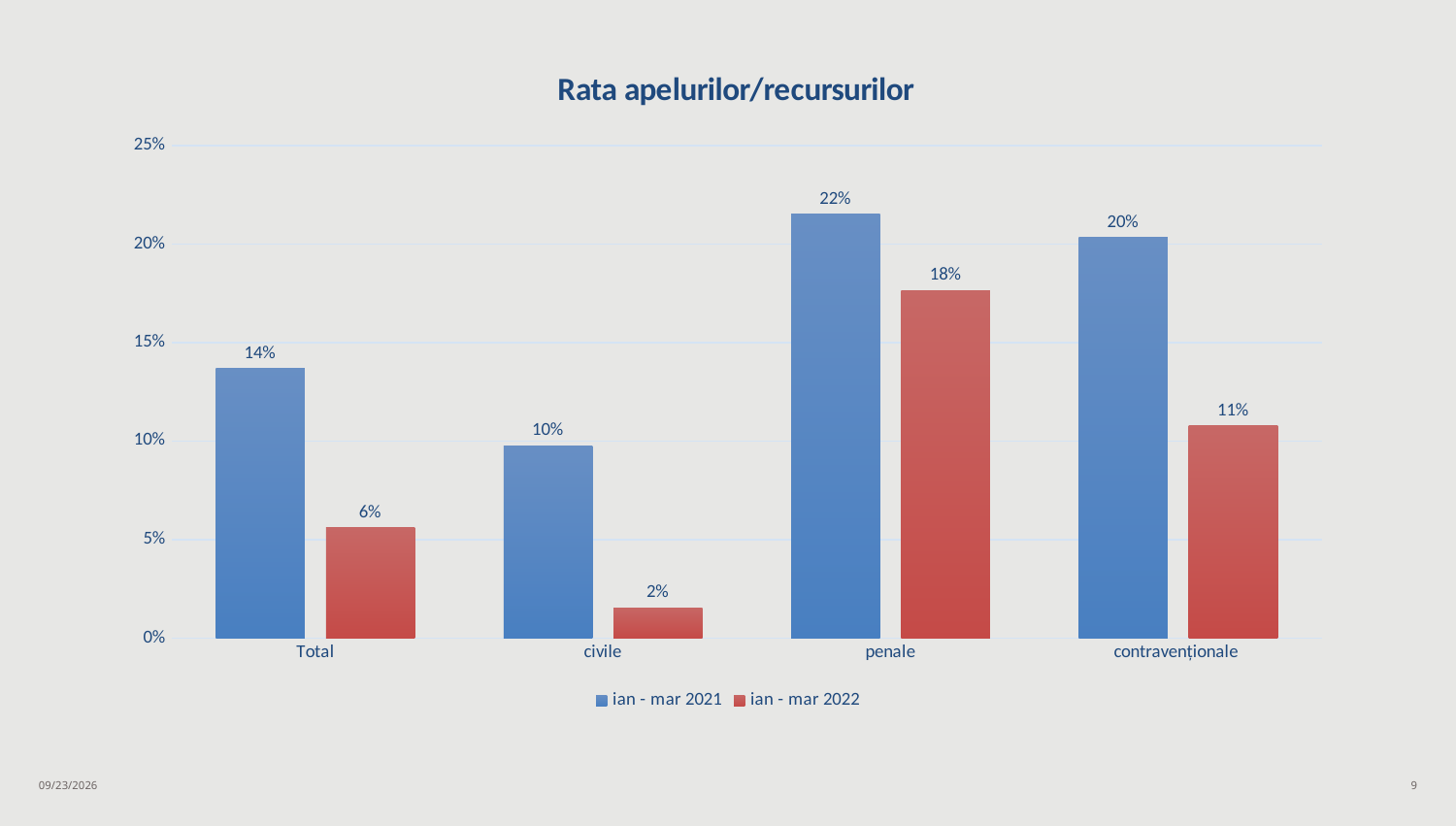
What is the value for contravenționale in the ian - mar 2022 series? 11% Which category has the lowest value in the ian - mar 2022 series? civile What is the title of the chart? Rata apelurilor/recursurilor Which is larger for Total: the ian - mar 2021 value or the ian - mar 2022 value? ian - mar 2021 What is the difference between the ian - mar 2021 and ian - mar 2022 values for contravenționale? 9% What kind of chart is shown on the slide? bar chart What is the value for civile in the ian - mar 2022 series? 2% How many series does the legend list? 2 Is the ian - mar 2022 value for penale greater or less than 15%? greater How many categories are shown on the x axis? 4 What is the value for penale in the ian - mar 2021 series? 22% Which category has the highest value in the ian - mar 2021 series? penale